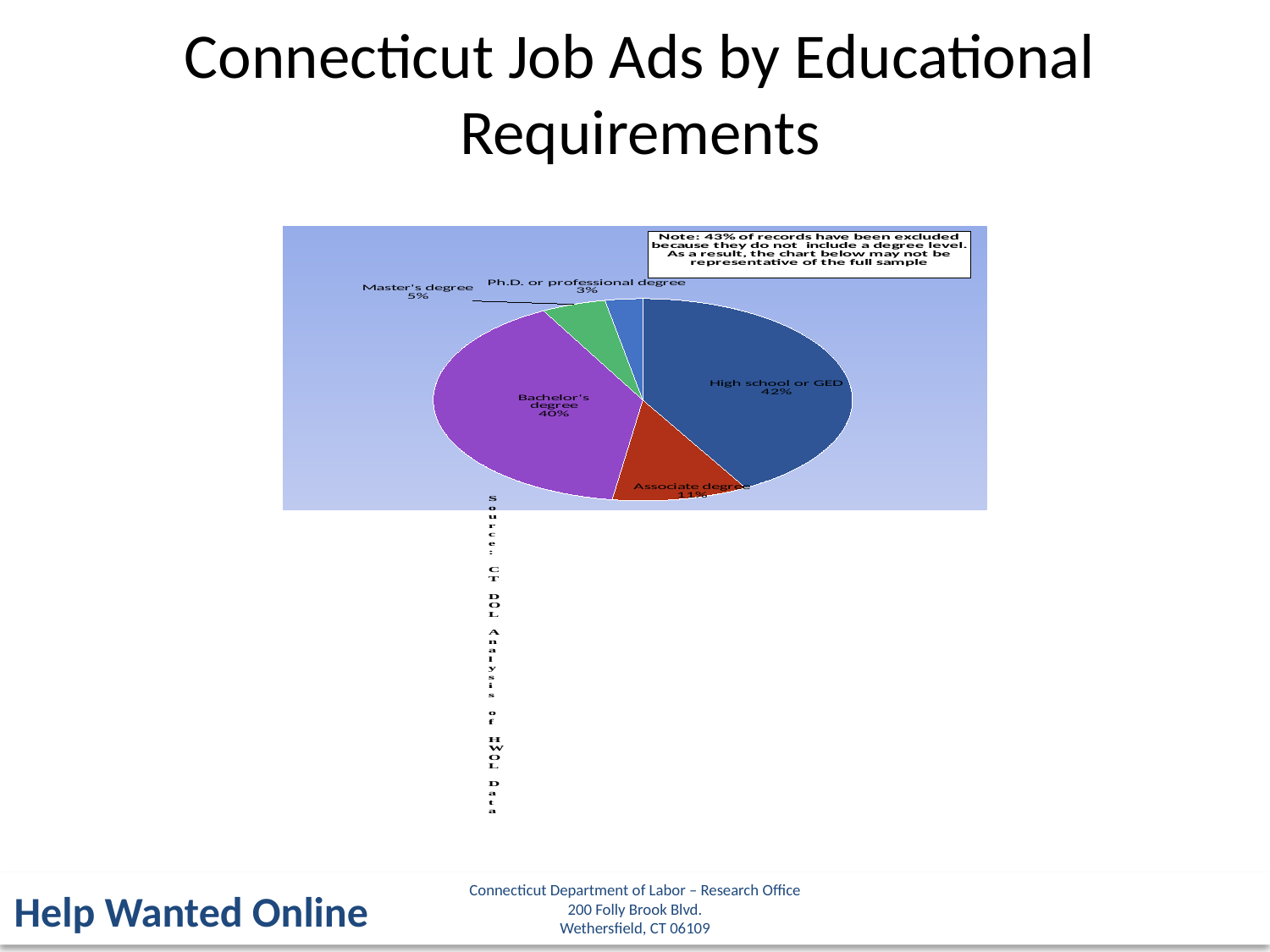
What share of job ads require a Master's degree? 5% According to the note on the chart, what percentage of records were excluded because they did not include a degree level? 43% What share of job ads require a Ph.D. or professional degree? 3% What kind of chart is shown on the slide? Pie chart Which educational requirement has the largest share of job ads? High school or GED What share of job ads require a Bachelor's degree? 40% Which is larger, the share for Master's degree or the share for Associate degree? Associate degree Which educational requirement has the smallest share of job ads? Ph.D. or professional degree What share of job ads require an Associate degree? 11% How many educational requirement categories are shown in the pie chart? 5 What share of job ads require a high school diploma or GED? 42% What is the difference in percentage points between the Bachelor's degree share and the Associate degree share? 29